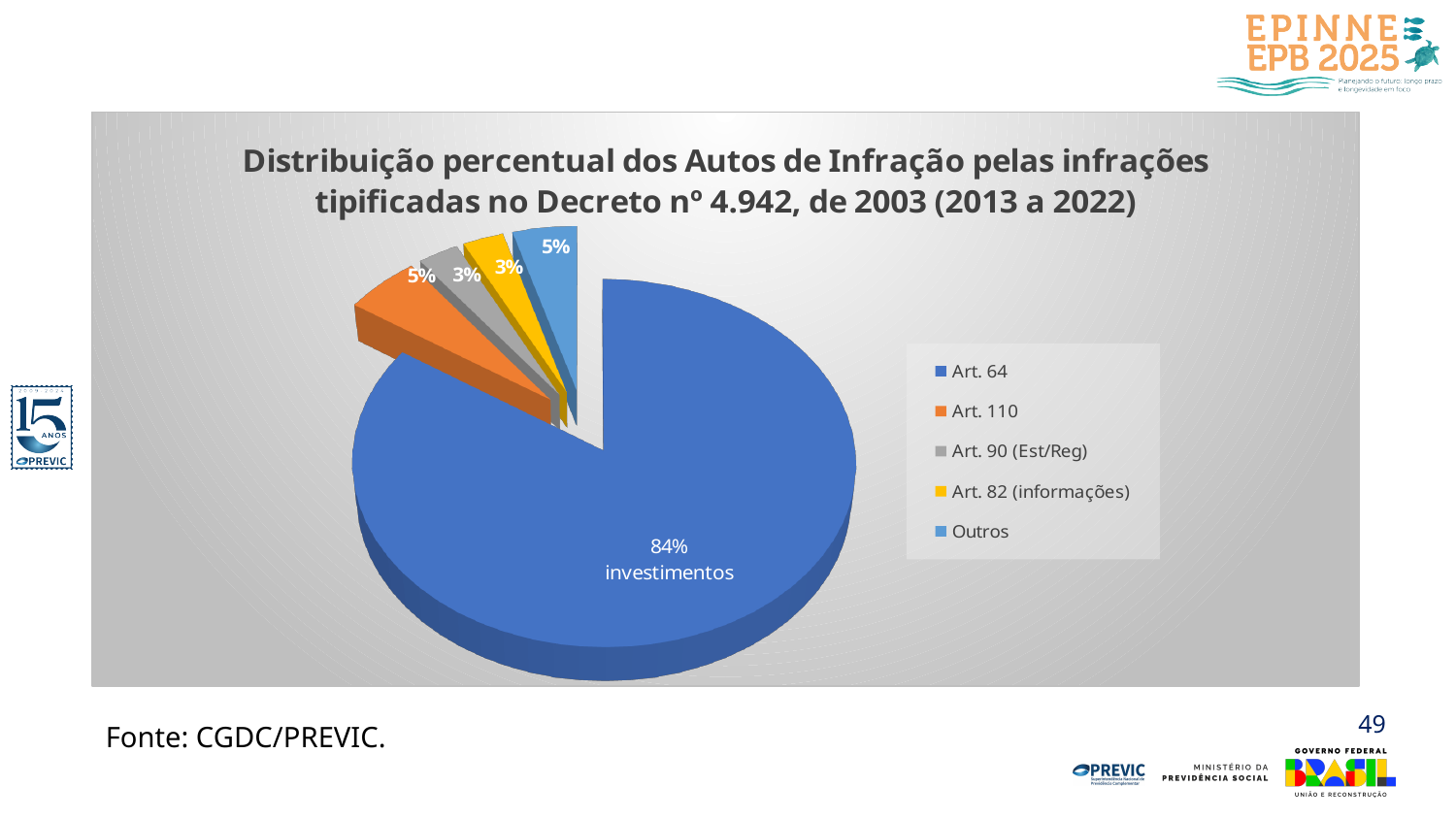
What is the value shown for Outros? 5% How many entries does the legend list? 5 What is the difference in percentage points between Art. 64 and Art. 110? 79 percentage points What word is printed below the 84% label on the largest slice? investimentos What is the value shown for Art. 82 (informações)? 3% What kind of chart is shown on the slide? Pie chart Which is larger, the share for Art. 110 or the share for Art. 90 (Est/Reg)? Art. 110 What is the value shown for Art. 90 (Est/Reg)? 3% What percentage of the pie does Art. 64 represent? 84% Which category has the largest share of the pie? Art. 64 What is the value shown for Art. 110? 5% How many slices does the pie chart have? 5